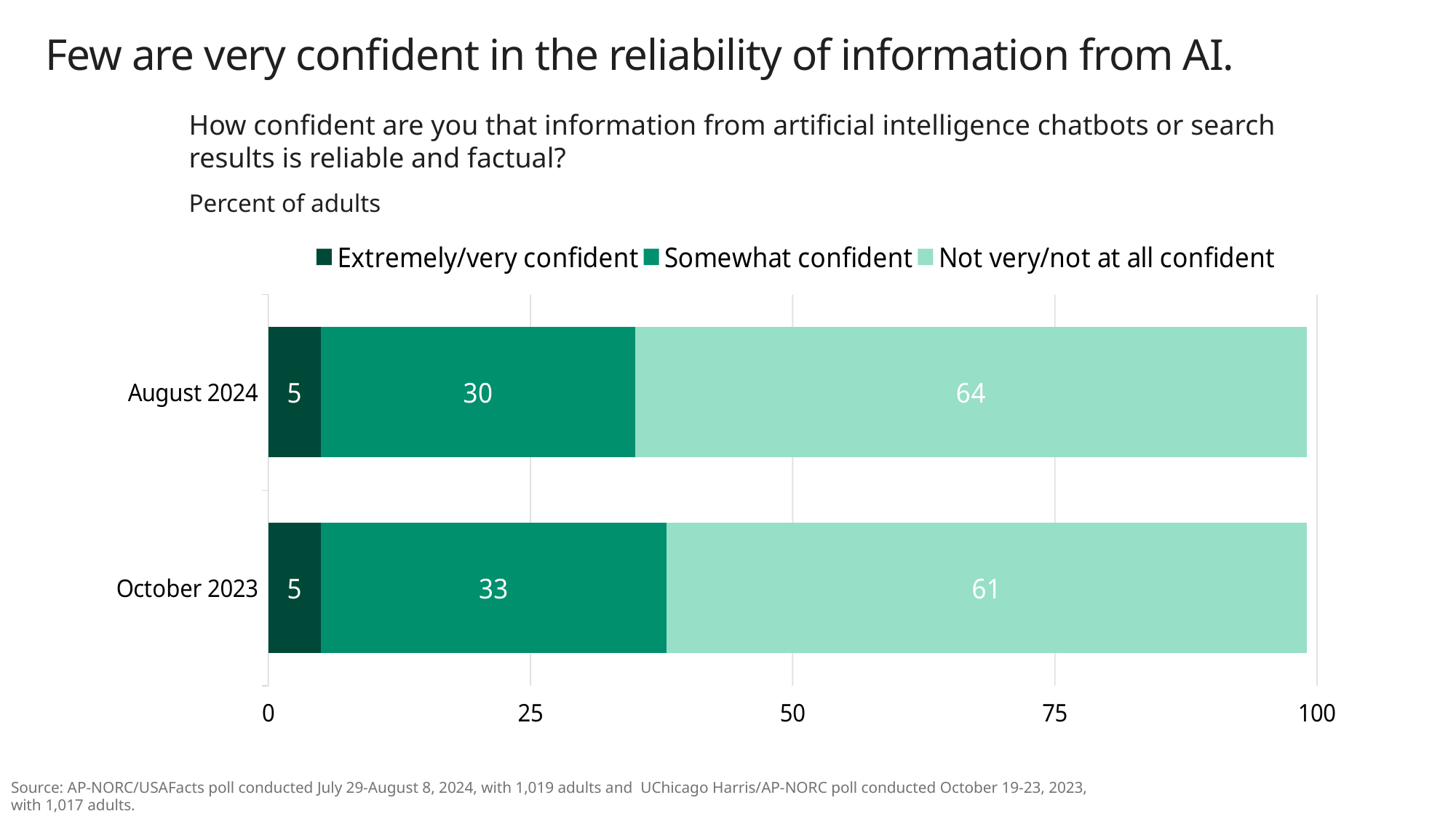
What is the total of the August 2024 stacked bar? 99 Which legend entry is shown in the lightest green colour? Not very/not at all confident Which survey date has the higher share of adults who were somewhat confident? October 2023 What percent of adults were not very/not at all confident in October 2023? 61 What is the difference in the not very/not at all confident share between August 2024 and October 2023? 3 What percent of adults were extremely/very confident in August 2024? 5 What kind of chart is shown on the slide? Stacked bar chart What is the total of the October 2023 stacked bar? 99 What percent of adults were somewhat confident in October 2023? 33 How many survey dates are shown on the chart? 2 What percent of adults were not very/not at all confident in August 2024? 64 How many series does the legend list? 3